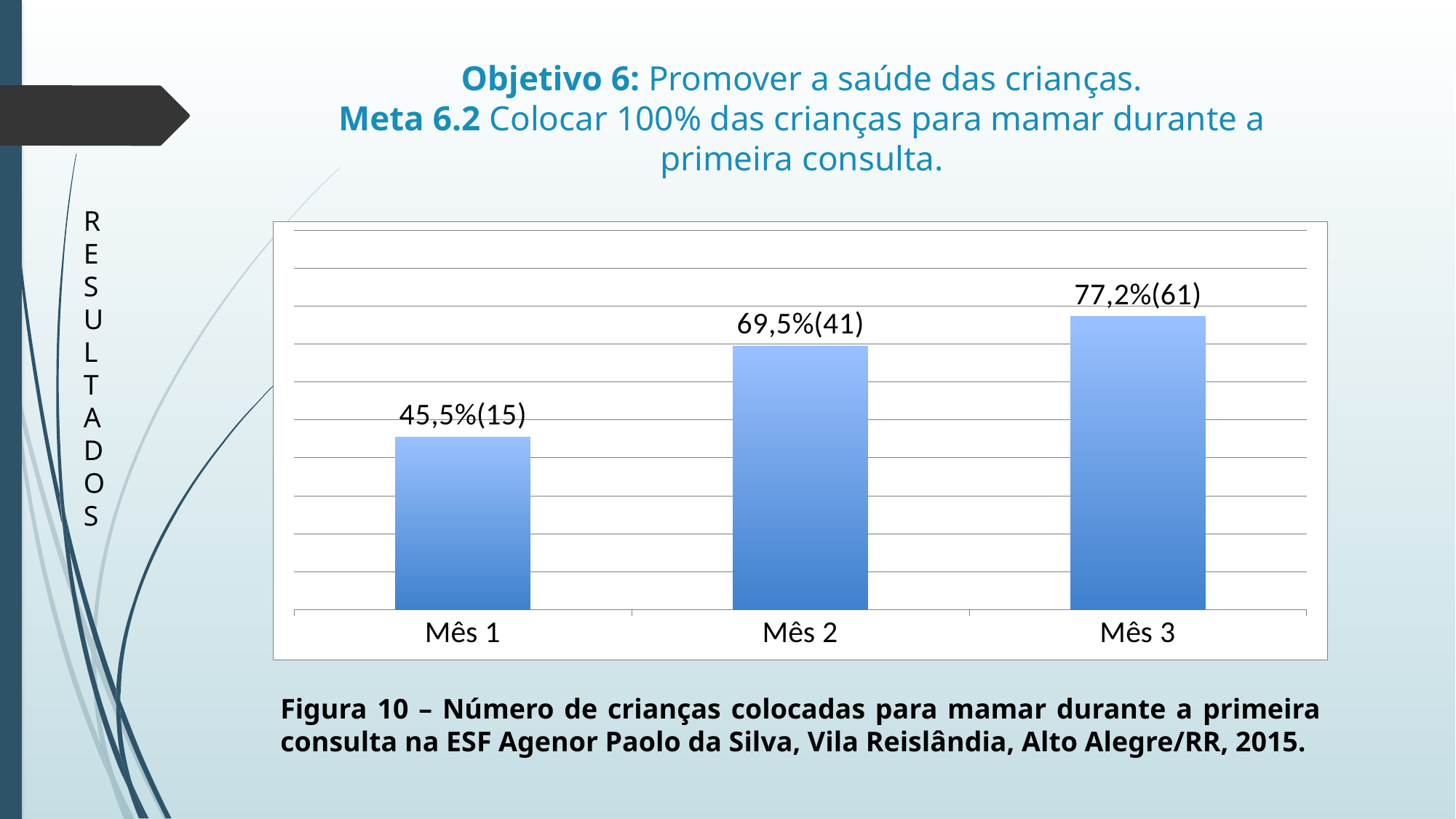
What is the data label shown for Mês 1? 45,5%(15) What is the data label shown for Mês 3? 77,2%(61) Which month has the lowest bar? Mês 1 How many children are shown in parentheses for Mês 2? 41 What kind of chart is shown on the slide? Bar chart How many more children are shown for Mês 3 than for Mês 1? 46 What percentage is shown for Mês 3? 77,2% Which month has the highest bar? Mês 3 What is the difference in percentage points between Mês 2 and Mês 1? 24,0 What is the data label shown for Mês 2? 69,5%(41) How many months (categories) are plotted on the chart? 3 Which is larger, the value for Mês 2 or the value for Mês 3? Mês 3